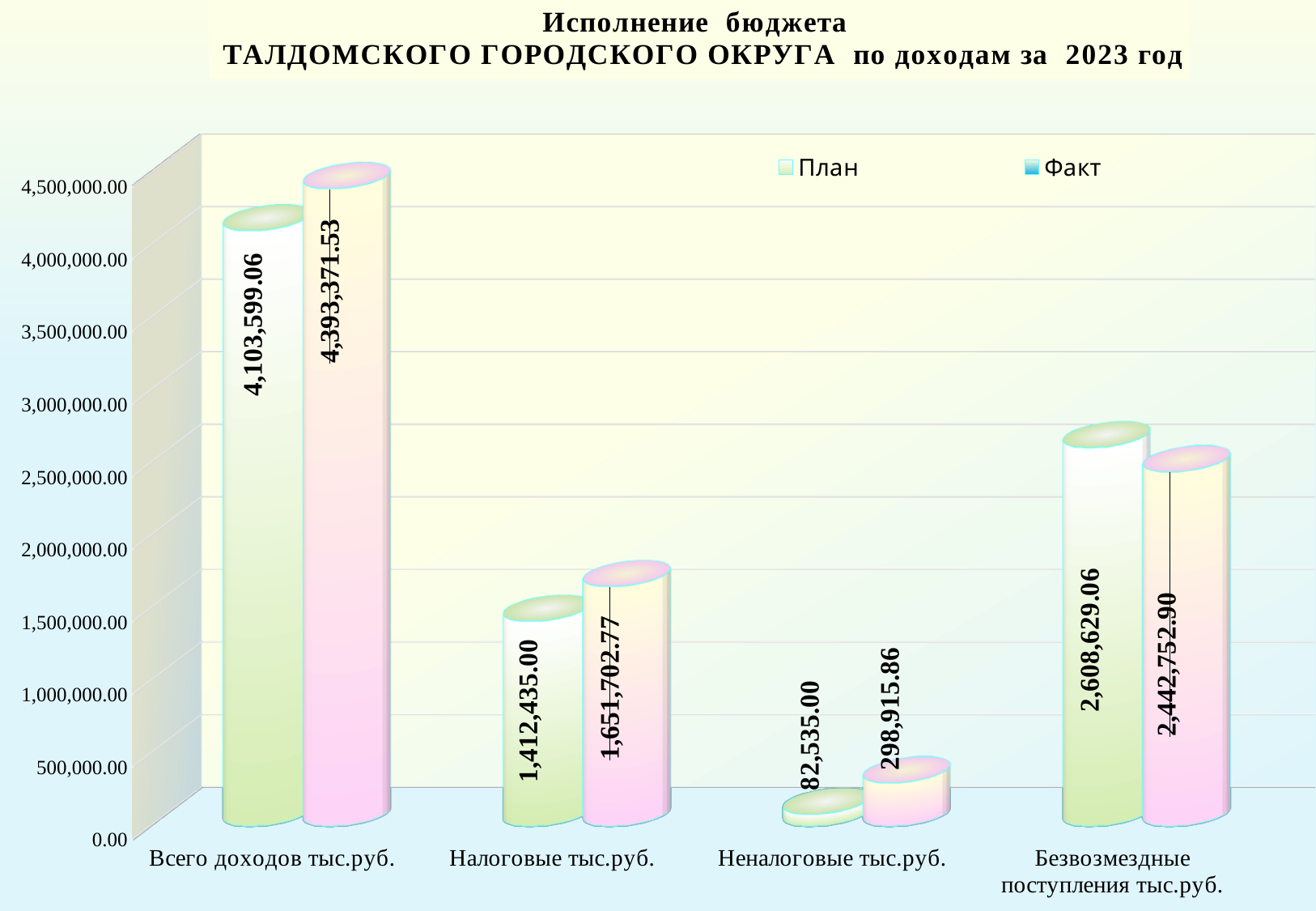
What is the План value for Безвозмездные поступления тыс.руб.? 2,608,629.06 What is the Факт value for Налоговые тыс.руб.? 1,651,702.77 What is the План value for Всего доходов тыс.руб.? 4,103,599.06 What is the difference between the План and Факт values for Безвозмездные поступления тыс.руб.? 165,876.16 How many categories are shown on the x axis? 4 How many series does the legend list? 2 What kind of chart is shown on the slide? Bar chart For Безвозмездные поступления тыс.руб., which is larger: План or Факт? План What is the Факт value for Неналоговые тыс.руб.? 298,915.86 What is the difference between the Факт and План values for Всего доходов тыс.руб.? 289,772.47 Which category has the highest План value? Всего доходов тыс.руб. Which category has the lowest Факт value? Неналоговые тыс.руб.